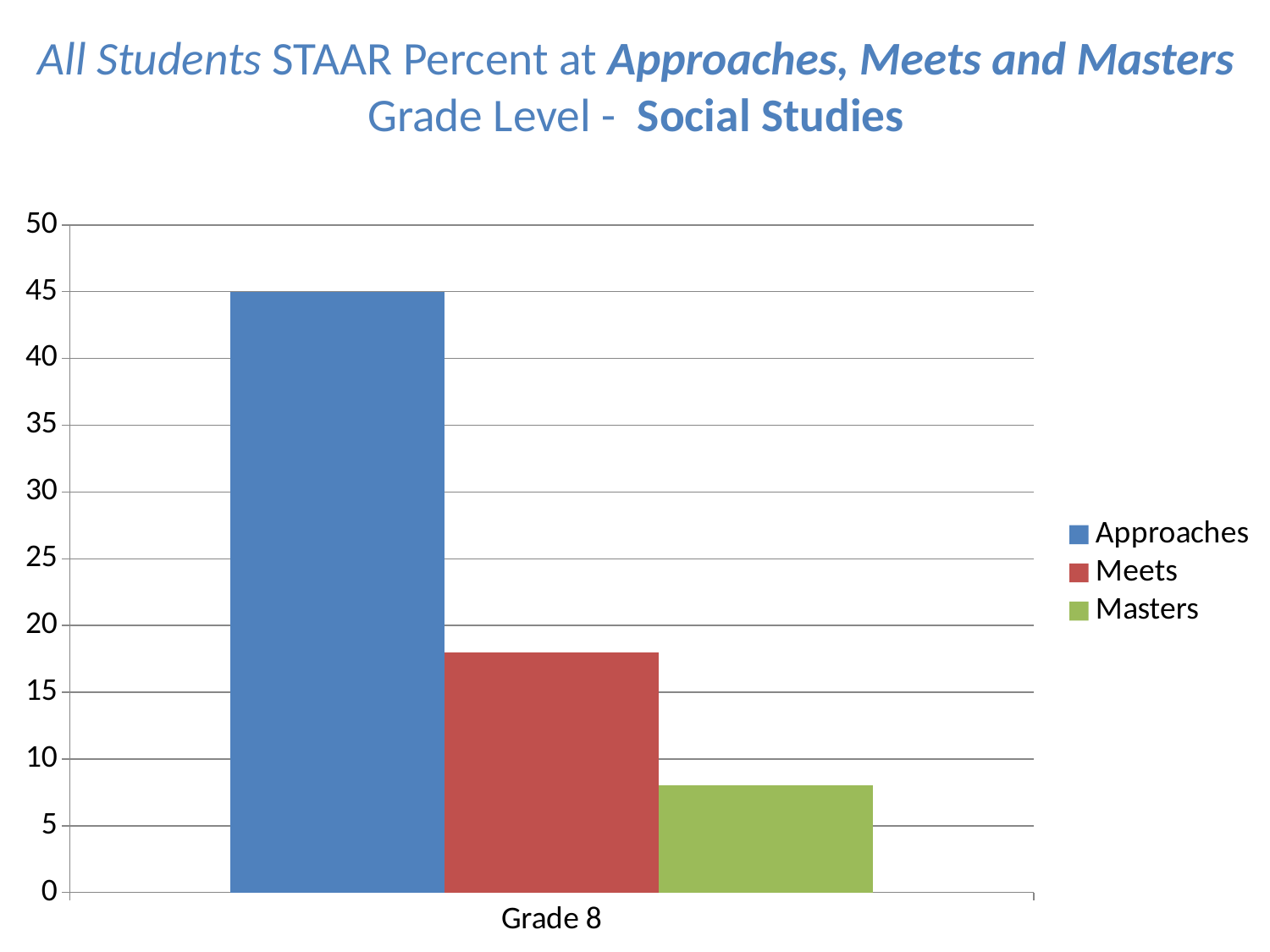
Which series has the highest value for Grade 8? Approaches How many series does the legend list? 3 Which series has the lowest value for Grade 8? Masters Is the value for Masters greater or less than 10? less What is the category label shown on the x axis? Grade 8 What is the value for Approaches for Grade 8? 45 Is the value for Approaches greater or less than 40? greater What colour represents the Meets series? red What kind of chart is shown on the slide? bar chart How many categories are shown on the x axis? 1 Which is larger for Grade 8, Meets or Masters? Meets Is the value for Meets greater or less than 15? greater